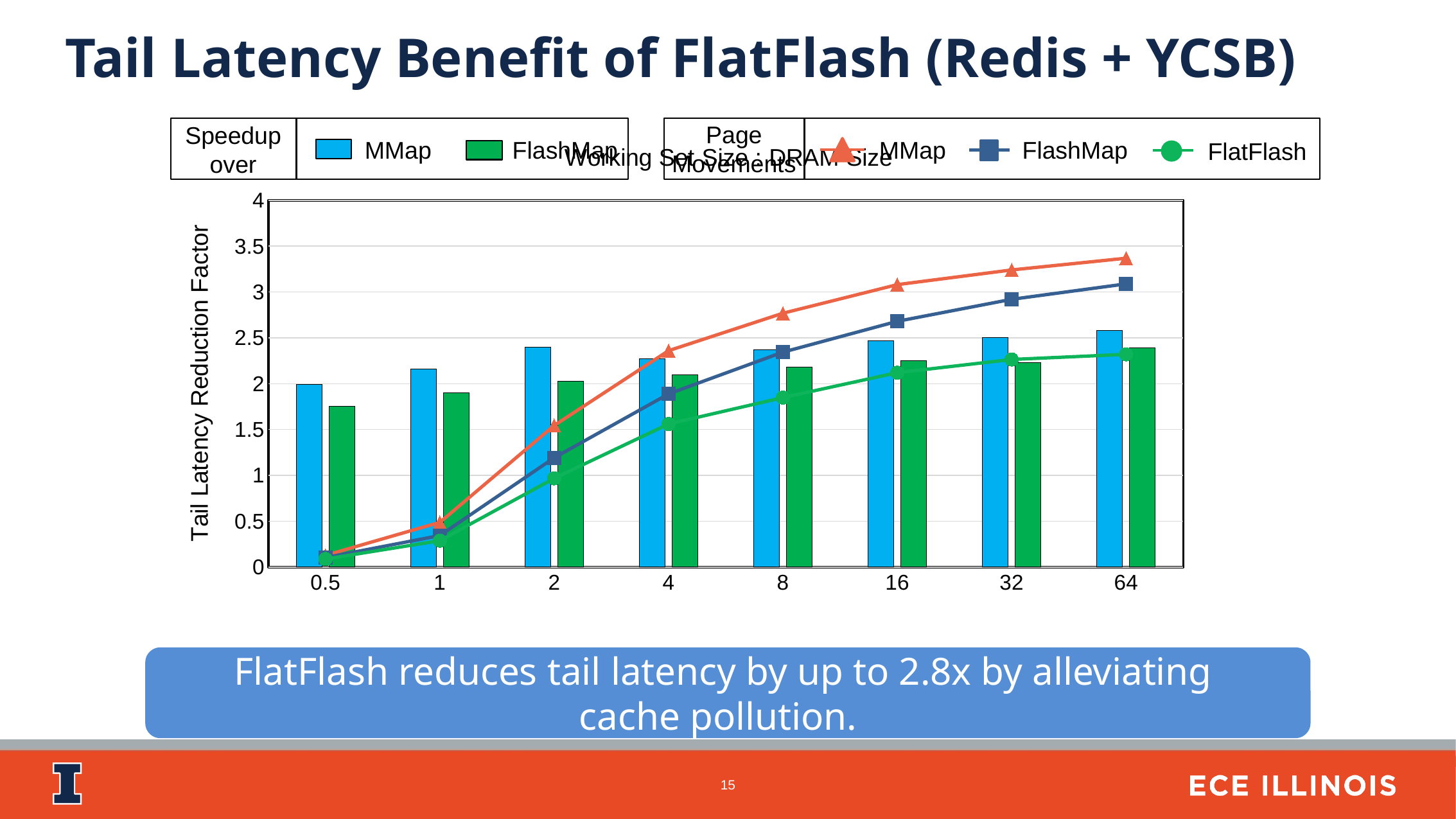
Do the page movements lines rise or fall as the working set size increases along the x axis? rise Is the FlatFlash page movements line value at working set size 0.5 greater or less than 0.5? less How many working set size categories are shown on the x axis? 8 What kind of chart is shown on the slide? A combined bar and line chart Which working set size category has the tallest 'Speedup over MMap' bar? 64 How many series does the 'Speedup over' legend list? 2 How many series does the 'Page Movements' legend list? 3 Is the 'Speedup over FlashMap' bar at working set size 0.5 greater or less than 2? less What is the label of the y axis? Tail Latency Reduction Factor Which working set size category has the shortest 'Speedup over FlashMap' bar? 0.5 Is the MMap page movements line value at working set size 64 greater or less than 3? greater At working set size 0.5, which bar is taller: 'Speedup over MMap' or 'Speedup over FlashMap'? Speedup over MMap